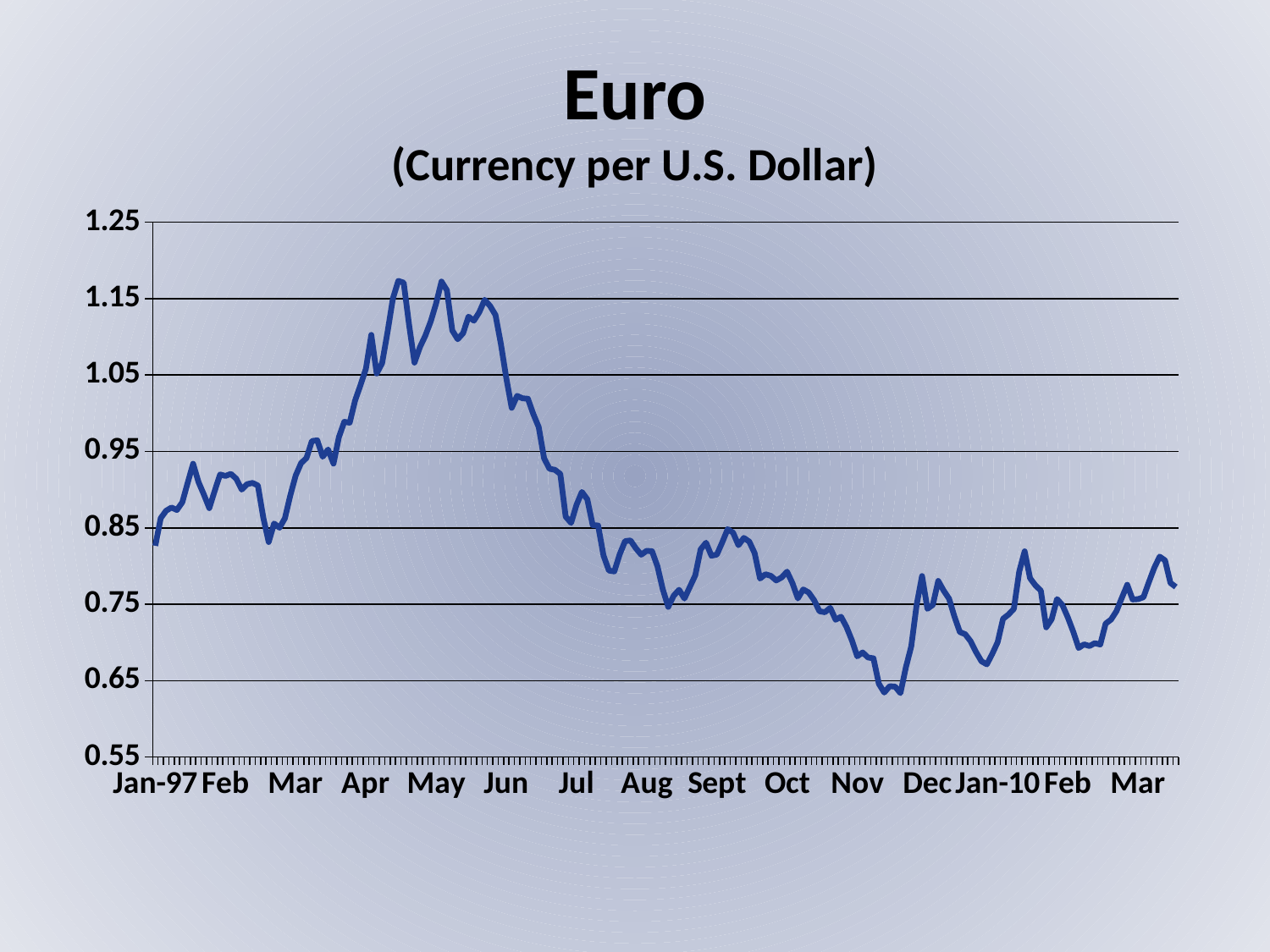
Is the value at Apr greater or less than 0.95? greater Is the lowest value reached by the line greater or less than 0.65? less Does the line generally rise or fall between Jun and Nov? fall How many month labels are shown along the x axis? 15 How many data series are plotted on the chart? 1 Is the value at Aug greater or less than 0.85? less Around which month does the line reach its lowest point? Nov What kind of chart is shown on the slide? line chart Does the line generally rise or fall between Jan-97 and Apr? rise What is the title of the chart? Euro (Currency per U.S. Dollar)